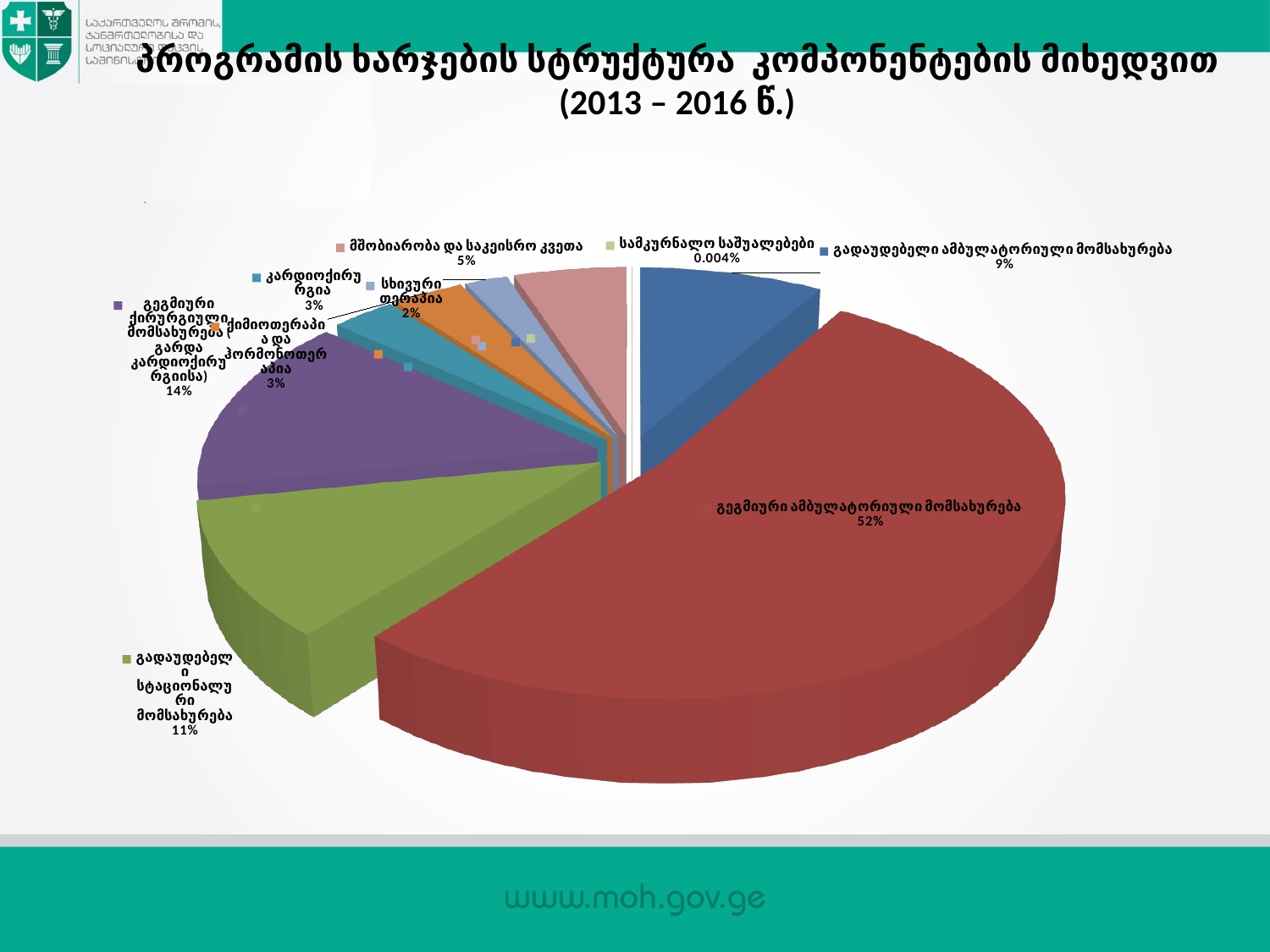
What percentage is shown for მშობიარობა და საკეისრო კვეთა? 5% What type of chart is shown on the slide? pie chart What percentage is shown for გადაუდებელი სტაციონალური მომსახურება? 11% What percentage is shown for გადაუდებელი ამბულატორიული მომსახურება? 9% How many slices does the pie chart have? 9 Which component has the smallest share of the pie? სამკურნალო საშუალებები Which component has the largest share of the pie? გეგმიური ამბულატორიული მომსახურება What share of the pie does გეგმიური ამბულატორიული მომსახურება have? 52% Which is larger: the share for გადაუდებელი სტაციონალური მომსახურება or the share for გადაუდებელი ამბულატორიული მომსახურება? გადაუდებელი სტაციონალური მომსახურება What percentage is shown for სხივური თერაპია? 2% What percentage is shown for სამკურნალო საშუალებები? 0.004% What is the difference in percentage points between გეგმიური ამბულატორიული მომსახურება (52%) and გეგმიური ქირურგიული მომსახურება (14%)? 38